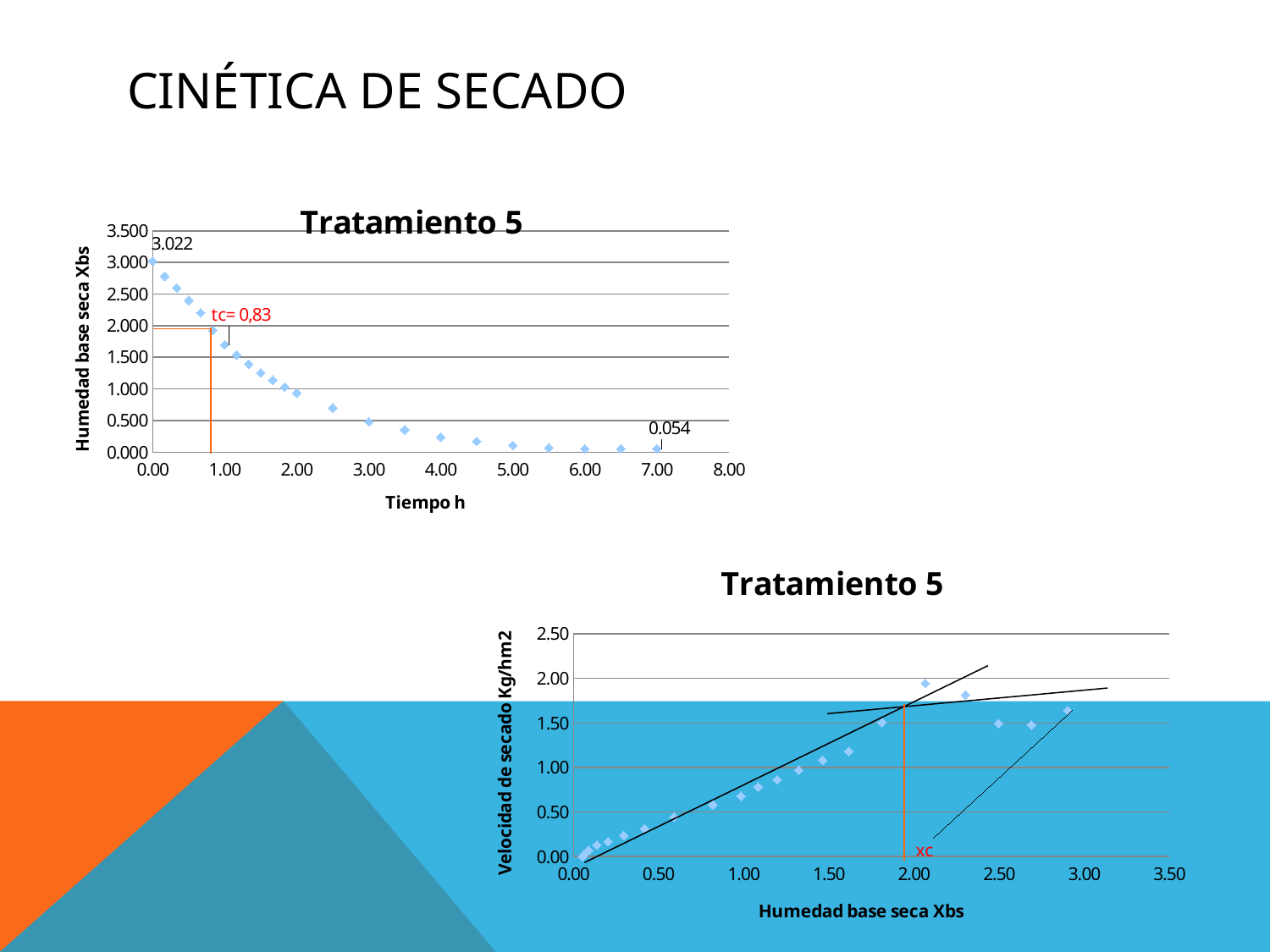
What is the y-axis title of the bottom chart (Tratamiento 5)? Velocidad de secado Kg/hm2 In the bottom chart (Velocidad de secado vs Humedad base seca Xbs), is the value at Humedad 2.50 greater or less than 1.00? greater In the top chart (Humedad base seca Xbs vs Tiempo h), what is the labelled value at time 7.00? 0.054 In the top chart, what value of tc is annotated in red? tc= 0,83 In the top chart (Humedad base seca Xbs vs Tiempo h), which is larger: the value at time 0.00 or the value at time 7.00? the value at time 0.00 In the top chart (Humedad base seca Xbs vs Tiempo h), what is the difference between the labelled values at time 0.00 and time 7.00? 2.968 In the top chart (Humedad base seca Xbs vs Tiempo h), is the value at time 1.00 greater or less than 1.000? greater In the top chart (Humedad base seca Xbs vs Tiempo h), is the value at time 3.00 greater or less than 1.000? less What kind of chart is the top chart (Humedad base seca Xbs vs Tiempo h)? scatter chart In the top chart (Humedad base seca Xbs vs Tiempo h), do the values rise or fall as time increases? fall In the top chart (Tratamiento 5, Humedad base seca Xbs vs Tiempo h), what is the labelled value at time 0.00? 3.022